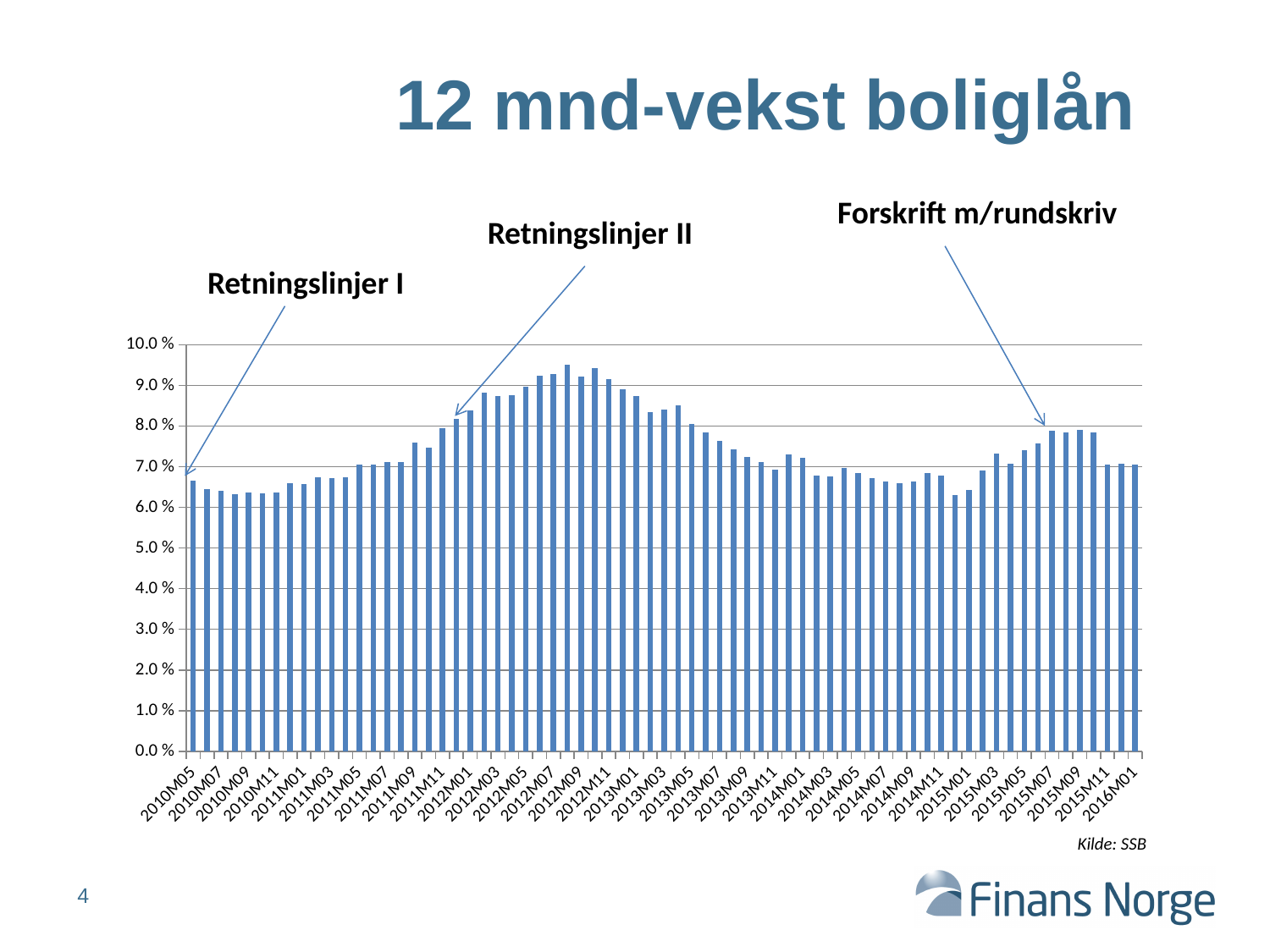
Is the value for 2010M05 greater or less than 7.0 %? less Is the value for 2015M01 greater or less than 7.0 %? less Do the values rise or fall from 2012M09 to 2014M07? fall What kind of chart is shown on the slide? bar chart Which is larger, the value for 2013M01 or the value for 2014M01? 2013M01 Is the value for 2011M09 greater or less than 7.0 %? greater In which year does the chart reach its highest value? 2012 Which is larger, the value for 2012M09 or the value for 2010M05? 2012M09 What source is cited below the chart? Kilde: SSB What is the title of the chart on the slide? 12 mnd-vekst boliglån